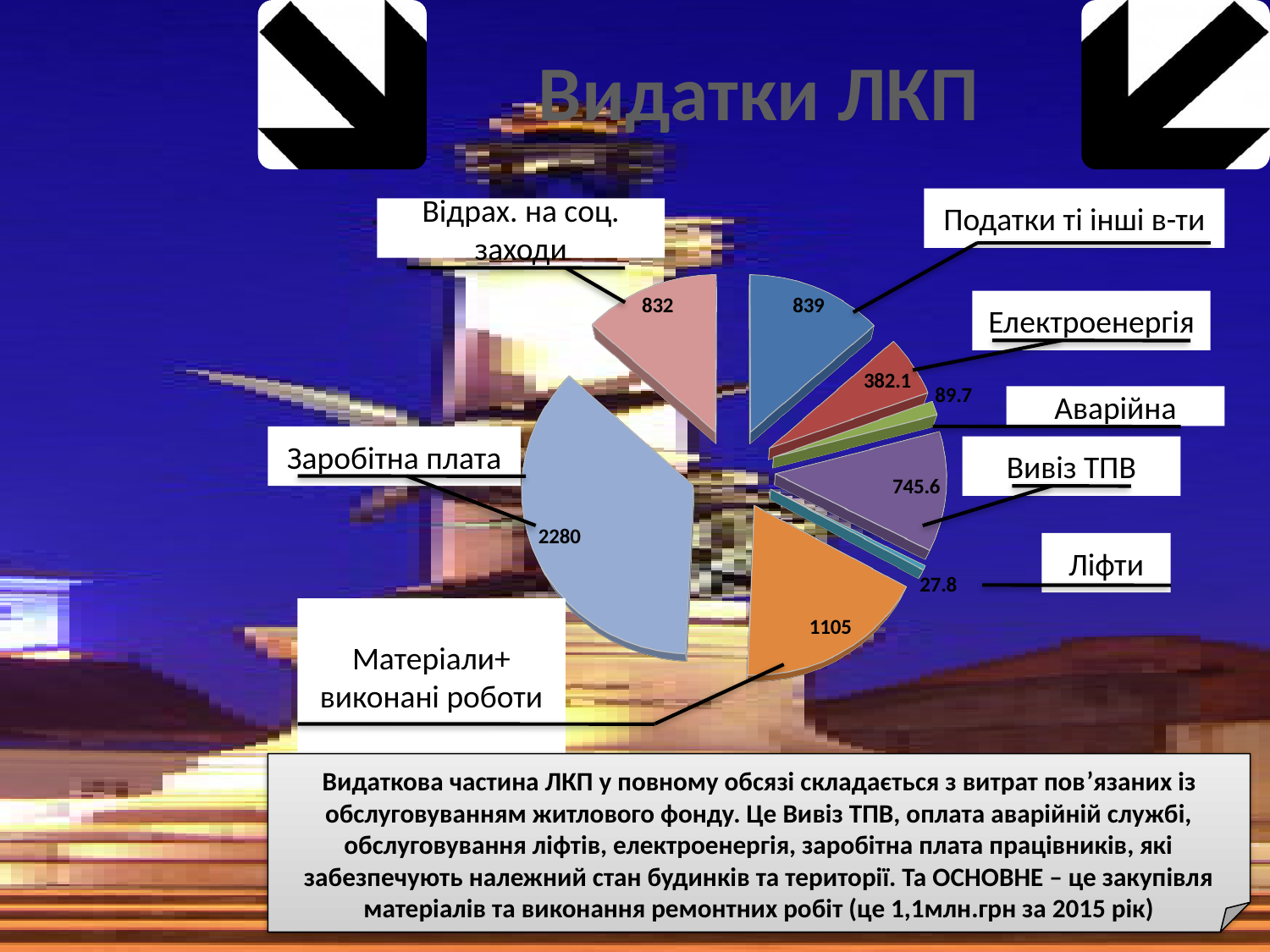
What is the value for Заробітна плата? 2280 What is the value for Матеріали+виконані роботи? 1105 Which category has the largest slice? Заробітна плата How many slices does the pie chart have? 8 What is the difference between the values for Податки ті інші в-ти and Відрах. на соц. заходи? 7 Which is larger, the value for Аварійна or the value for Ліфти? Аварійна What is the title of the chart? Видатки ЛКП What is the value for Електроенергія? 382.1 What is the difference between the values for Матеріали+виконані роботи and Вивіз ТПВ? 359.4 What kind of chart is shown on the slide? pie chart Which category has the smallest slice? Ліфти What is the value for Вивіз ТПВ? 745.6